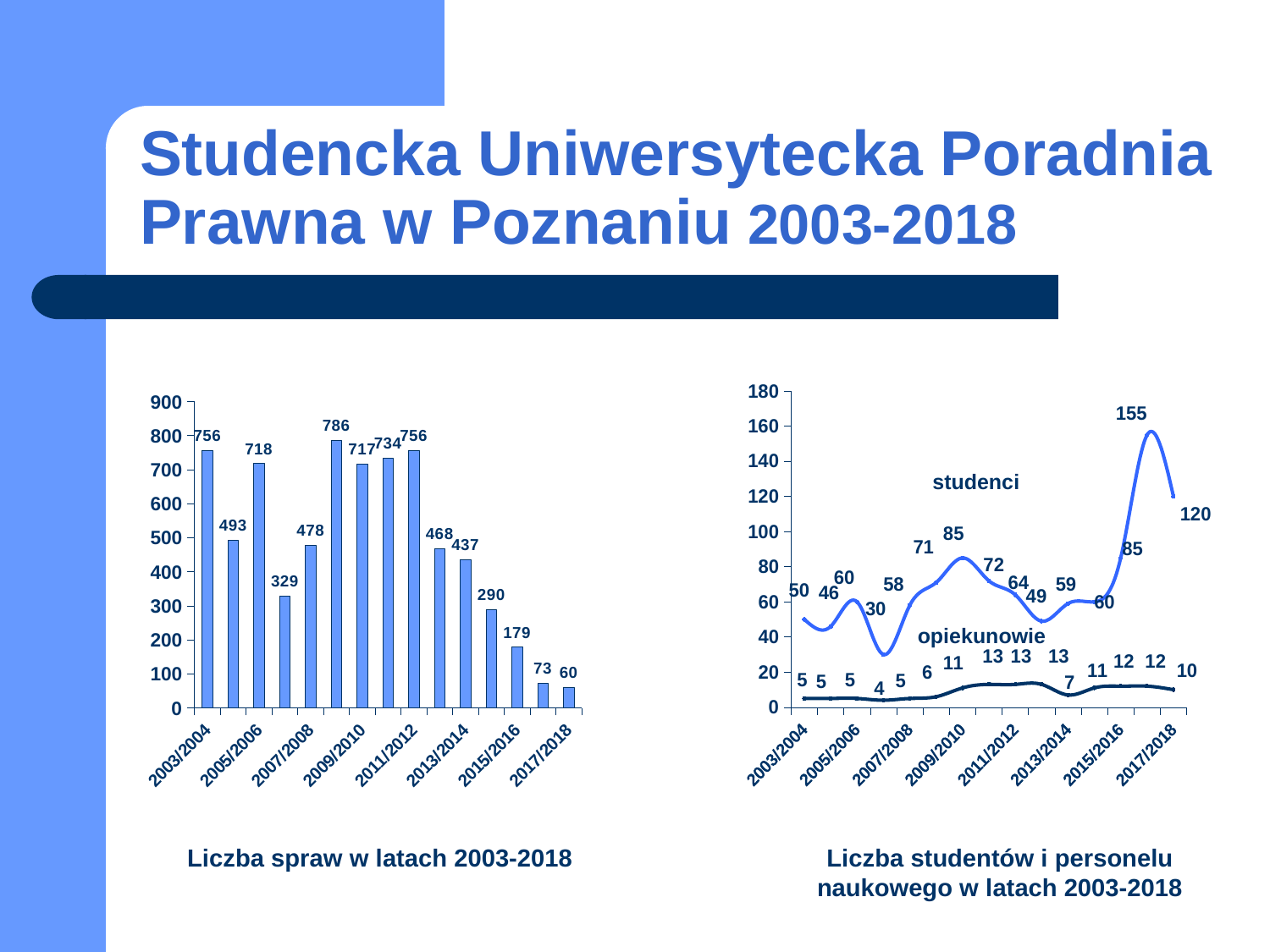
What kind of chart is the right chart, 'Liczba studentów i personelu naukowego w latach 2003-2018'? line chart In the left chart 'Liczba spraw w latach 2003-2018', what is the value for 2015/2016? 179 In the right chart 'Liczba studentów i personelu naukowego w latach 2003-2018', what is the highest value of the 'studenci' series? 155 In the right chart 'Liczba studentów i personelu naukowego w latach 2003-2018', what is the 'opiekunowie' value for 2009/2010? 11 What kind of chart is the left chart, 'Liczba spraw w latach 2003-2018'? bar chart In the left chart 'Liczba spraw w latach 2003-2018', what is the value for 2003/2004? 756 In the right chart 'Liczba studentów i personelu naukowego w latach 2003-2018', what is the difference between the 'studenci' and 'opiekunowie' values for 2017/2018? 110 In the left chart 'Liczba spraw w latach 2003-2018', what is the highest value shown? 786 How many bars are in the left chart 'Liczba spraw w latach 2003-2018'? 15 How many series are plotted in the right chart 'Liczba studentów i personelu naukowego w latach 2003-2018'? 2 In the left chart 'Liczba spraw w latach 2003-2018', what is the lowest value shown? 60 In the left chart 'Liczba spraw w latach 2003-2018', what is the difference between the values for 2003/2004 and 2017/2018? 696